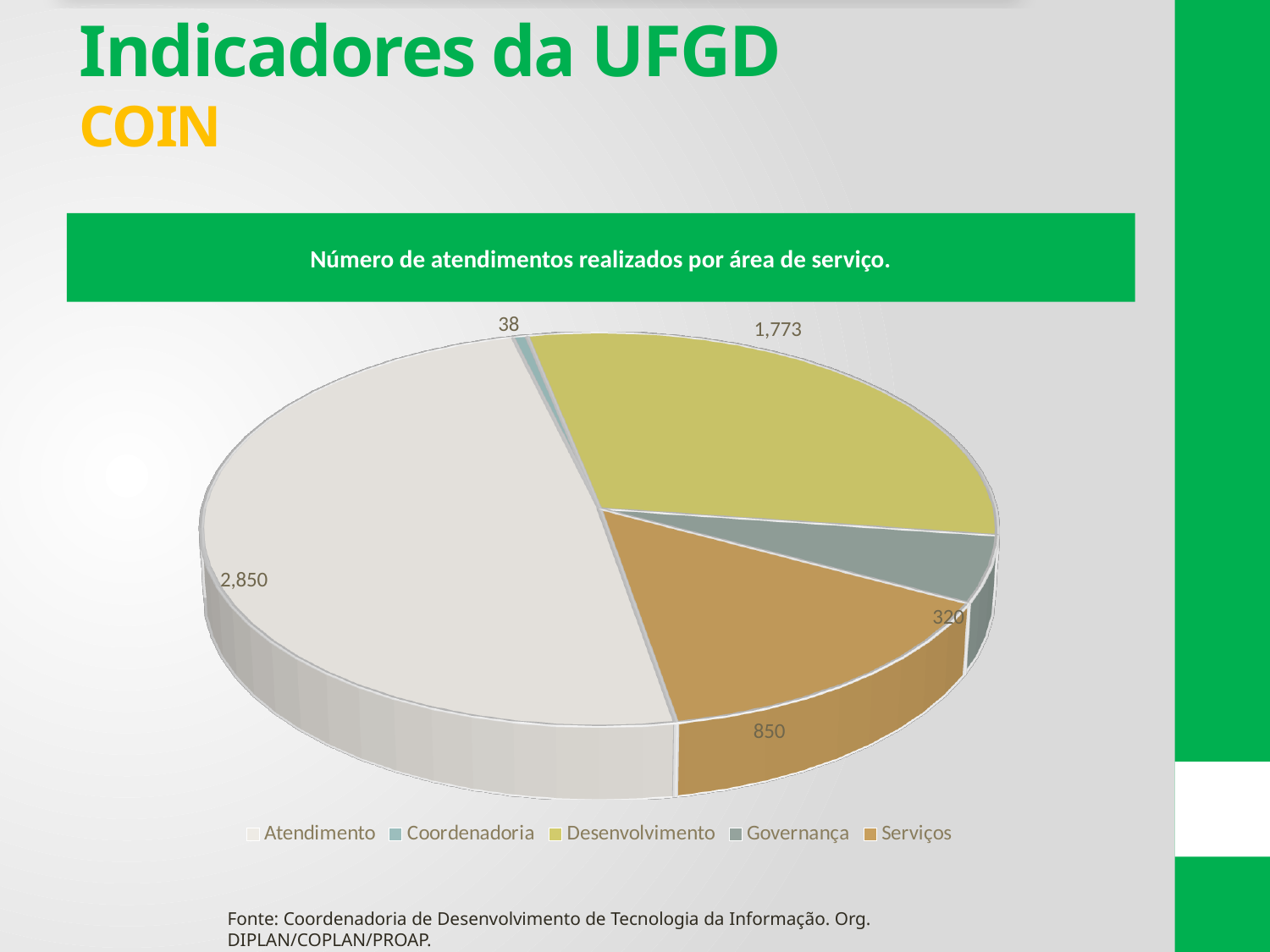
Which area has the smallest slice of the pie? Coordenadoria What kind of chart is shown on the slide? Pie chart What is the value shown for Coordenadoria? 38 Which area has the largest slice of the pie? Atendimento What is the difference between the values for Atendimento and Desenvolvimento? 1,077 How many categories does the legend of the pie chart list? 5 What is the number of atendimentos for Atendimento? 2,850 What is the total of all the values shown in the pie chart? 5,831 What is the value shown for Desenvolvimento? 1,773 What is the value shown for Serviços? 850 Which is larger, the value for Serviços or the value for Governança? Serviços What is the title of the chart? Número de atendimentos realizados por área de serviço.